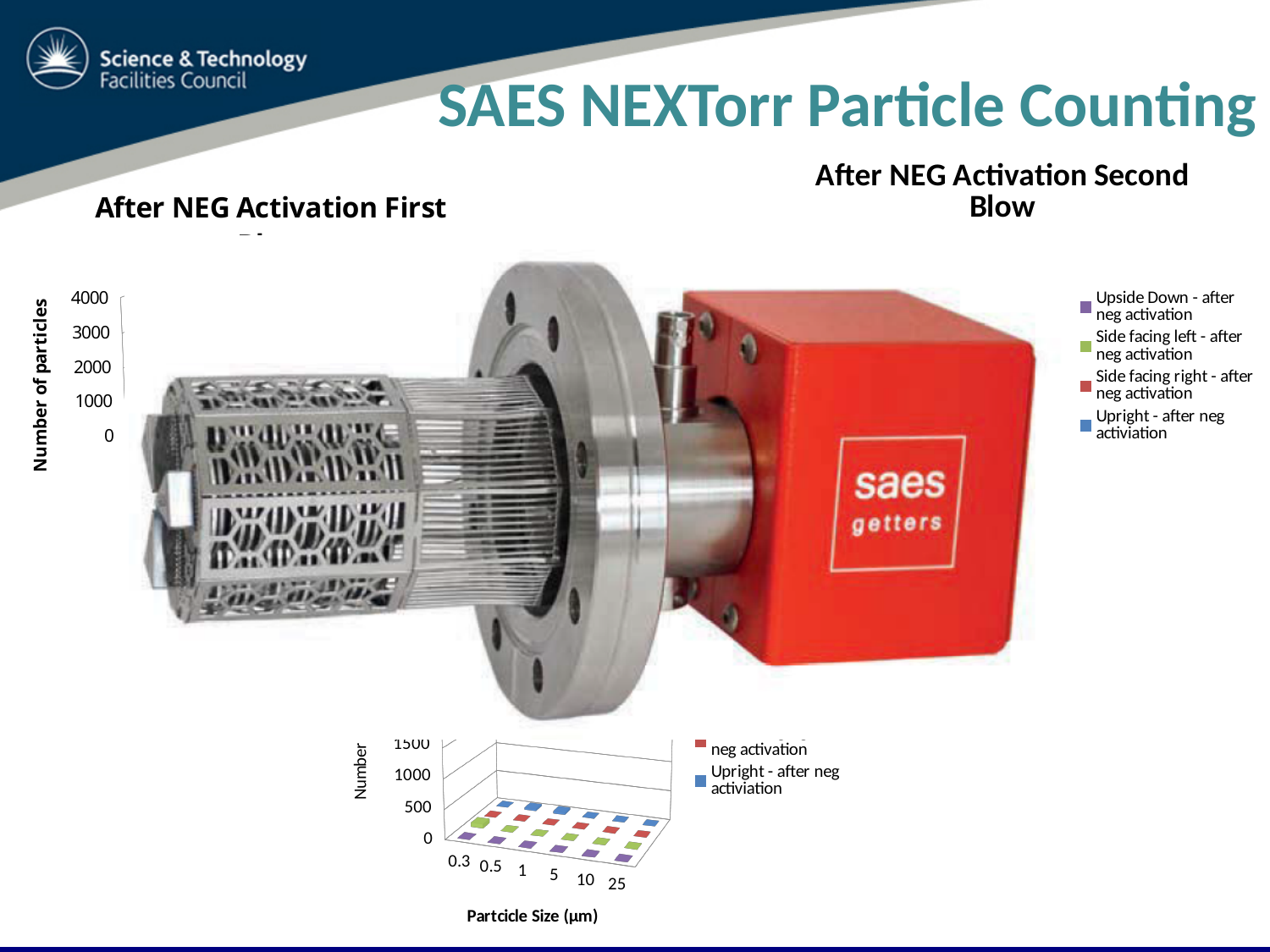
In the 'After NEG Activation First Blow' chart, what is the title of the vertical axis? Number of particles In the 'After NEG Activation Second Blow' chart, what is the largest particle size category labelled on the x axis? 25 In the 'After NEG Activation First Blow' chart, how many series does the legend list? 4 In the 'After NEG Activation First Blow' chart, what is the highest tick value shown on the vertical axis? 4000 In the 'After NEG Activation Second Blow' chart, how many particle size categories are shown on the x axis? 6 What kind of chart is the 'After NEG Activation Second Blow' chart? bar chart